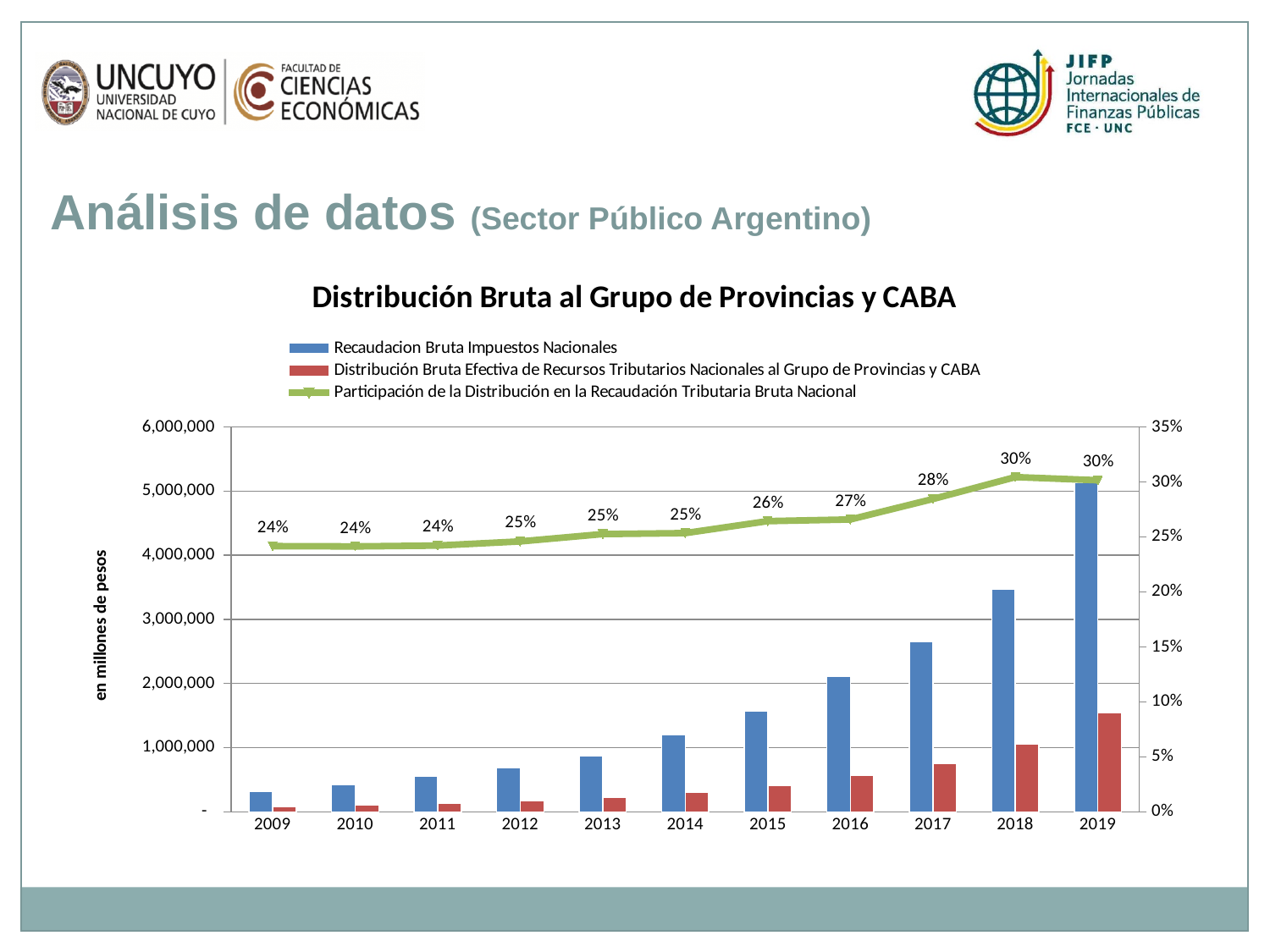
What is the value of Participación de la Distribución en la Recaudación Tributaria Bruta Nacional for 2019? 30% How many years are shown on the x axis? 11 What kind of chart is shown on the slide? bar chart with a line Is the value of Distribución Bruta Efectiva de Recursos Tributarios Nacionales al Grupo de Provincias y CABA for 2019 greater or less than 1,000,000? greater In which year is Recaudacion Bruta Impuestos Nacionales highest? 2019 Does the Participación de la Distribución line rise or fall from 2009 to 2019? rise What is the value of Participación de la Distribución en la Recaudación Tributaria Bruta Nacional for 2017? 28% How many series does the legend list? 3 Is the value of Recaudacion Bruta Impuestos Nacionales for 2018 greater or less than 3,000,000? greater What is the value of Participación de la Distribución en la Recaudación Tributaria Bruta Nacional for 2009? 24% What is the title of the chart? Distribución Bruta al Grupo de Provincias y CABA By how many percentage points did the Participación de la Distribución rise from 2009 to 2019? 6 percentage points